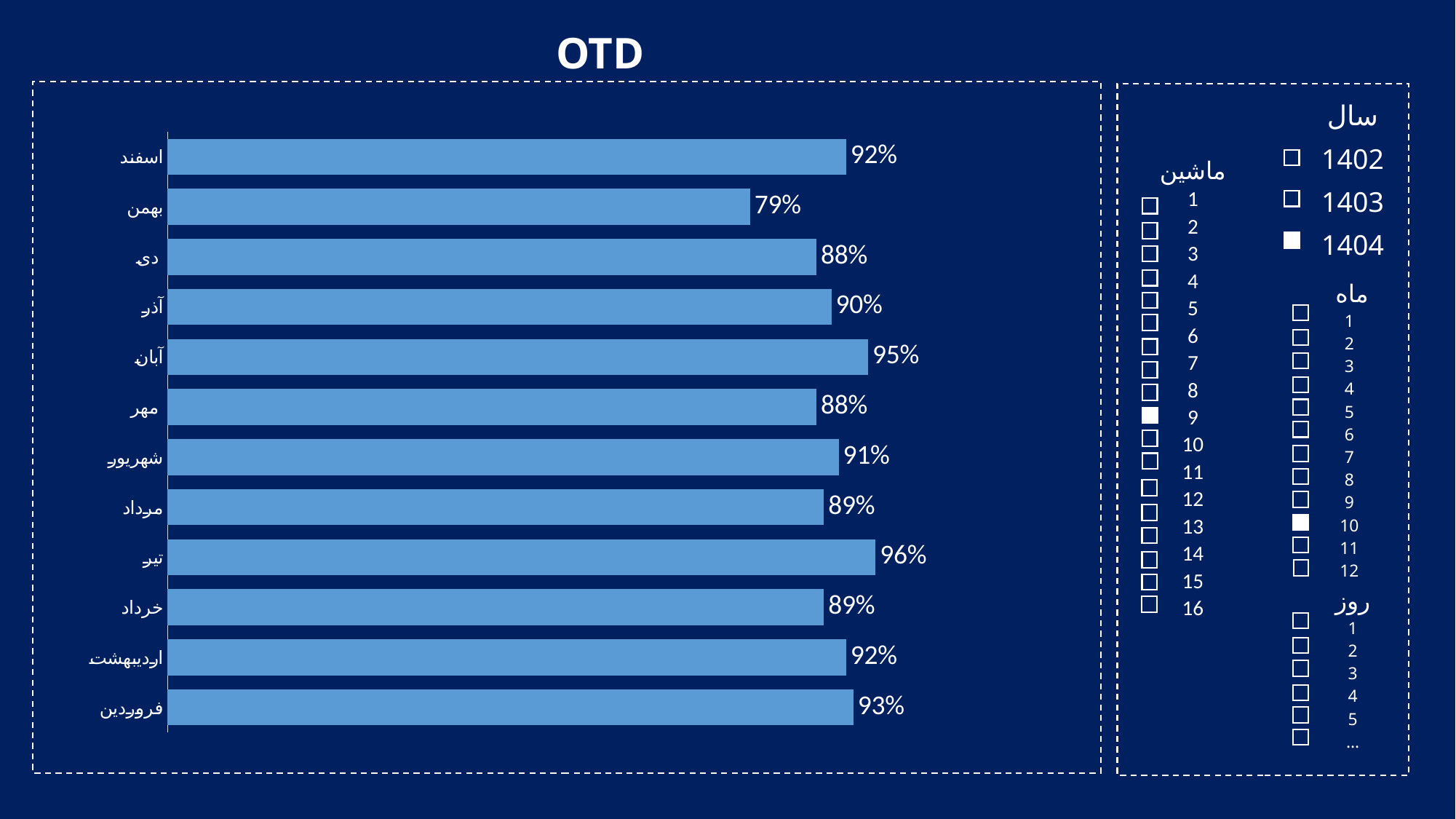
How many months are shown in the chart? 12 What kind of chart is shown on the slide? bar chart Which month has the lowest OTD value? بهمن What is the OTD value for آبان? 95% What is the title of the chart? OTD What is the OTD value for بهمن? 79% What is the OTD value for فروردین? 93% What is the difference between the OTD values for تیر and بهمن? 17% Which has a higher OTD value, اسفند or دی? اسفند What is the difference between the OTD values for آبان and آذر? 5% Which month has the highest OTD value? تیر What is the OTD value for تیر? 96%